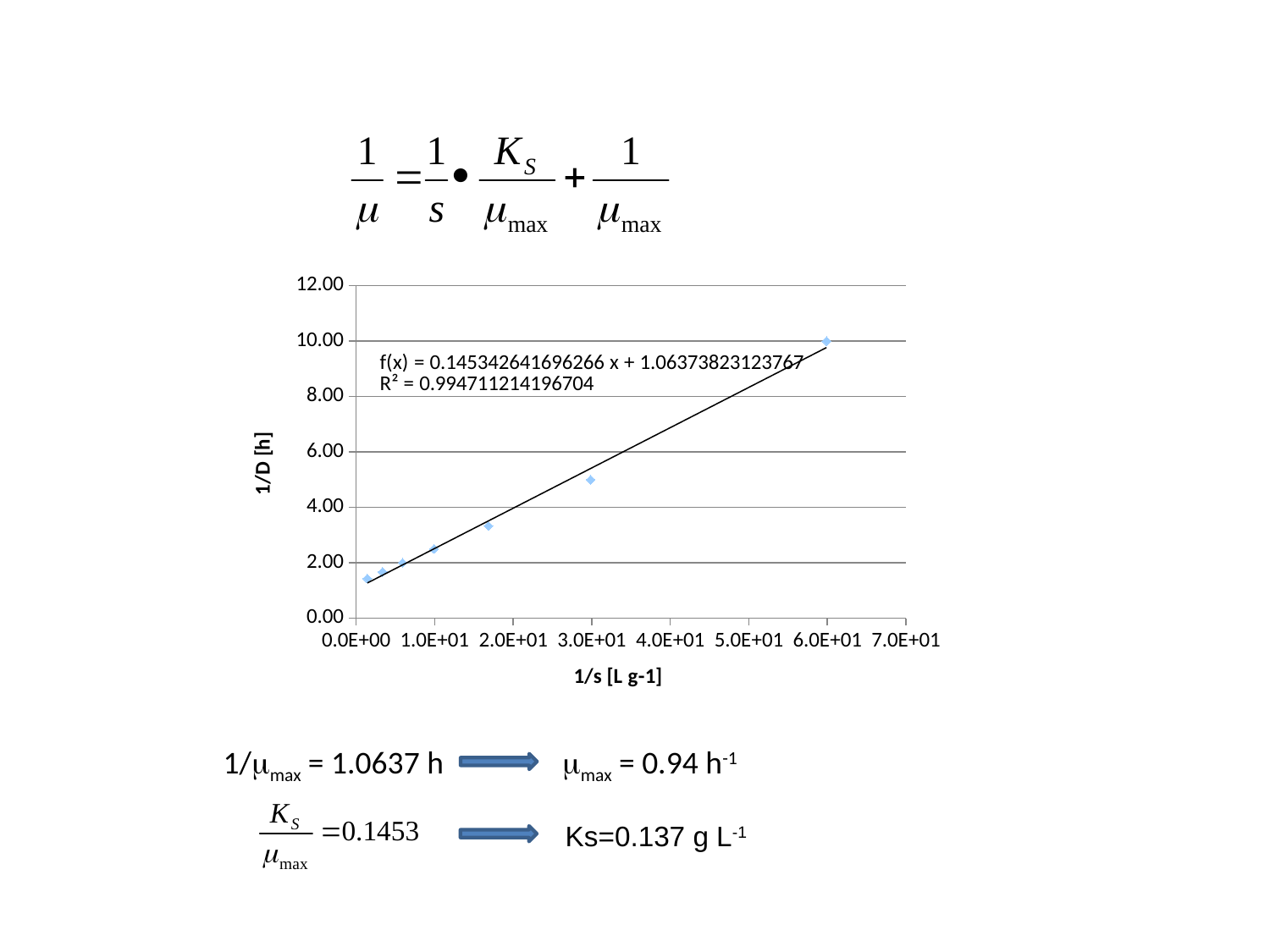
Is the 1/D value of the point at 1/s = 6.0E+01 greater or less than 8.00? greater What kind of chart is shown on the slide? scatter chart What is the label of the y axis of the chart? 1/D [h] What is the R² value printed on the chart? 0.994711214196704 At which x value does the point with the highest 1/D value lie? 6.0E+01 What is the maximum value shown on the y axis of the chart? 12.00 Is the 1/D value of the point at 1/s = 0.0E+00 greater or less than 2.00? less Do the plotted values rise or fall as 1/s increases along the x axis? rise Is the 1/D value of the point at 1/s = 3.0E+01 greater or less than 4.00? greater Which of the two points has the larger 1/D value: the one at 1/s = 3.0E+01 or the one at 1/s = 6.0E+01? the one at 1/s = 6.0E+01 How many data points are plotted on the chart? 7